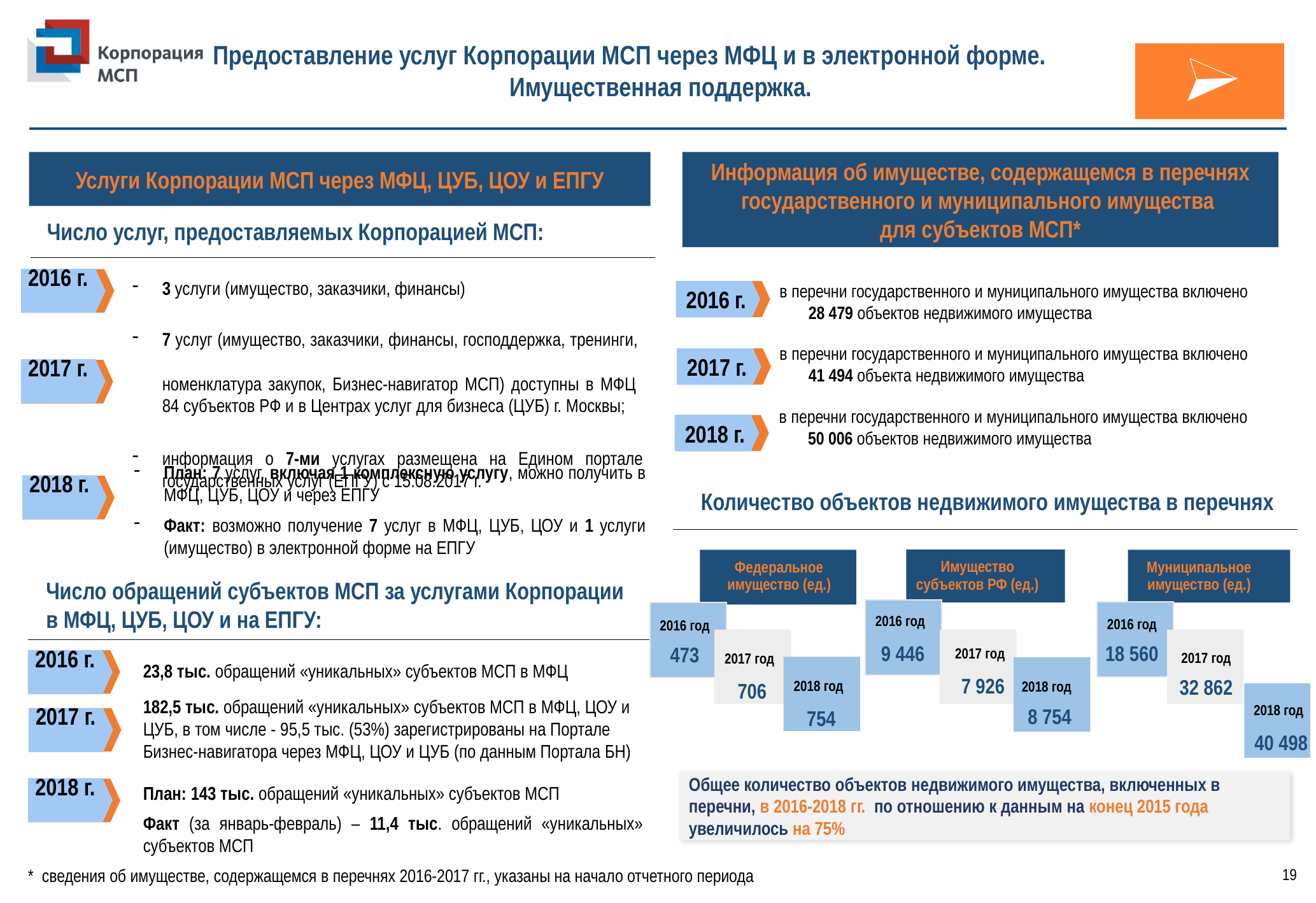
In the chart 'Количество объектов недвижимого имущества в перечнях', what is the value for Имущество субъектов РФ in 2017 год? 7 926 In the chart 'Количество объектов недвижимого имущества в перечнях', what is the difference between the 2018 год and 2016 год values for Федеральное имущество? 281 In the chart 'Количество объектов недвижимого имущества в перечнях', which year has the lowest value for Имущество субъектов РФ? 2017 год In the chart 'Количество объектов недвижимого имущества в перечнях', which year has the highest value for Муниципальное имущество? 2018 год In the chart 'Количество объектов недвижимого имущества в перечнях', how many years are shown for each property category? 3 In the chart 'Количество объектов недвижимого имущества в перечнях', which is larger: Имущество субъектов РФ in 2016 год or in 2018 год? 2016 год In the chart 'Количество объектов недвижимого имущества в перечнях', what is the value for Федеральное имущество in 2016 год? 473 In the chart 'Количество объектов недвижимого имущества в перечнях', how many property categories are shown? 3 In the chart 'Количество объектов недвижимого имущества в перечнях', what is the difference between the 2017 год and 2016 год values for Муниципальное имущество? 14 302 In the chart 'Количество объектов недвижимого имущества в перечнях', which property category has the highest value in 2018 год? Муниципальное имущество In the chart 'Количество объектов недвижимого имущества в перечнях', do the values for Федеральное имущество rise or fall from 2016 год to 2018 год? rise In the chart 'Количество объектов недвижимого имущества в перечнях', what is the value for Муниципальное имущество in 2018 год? 40 498